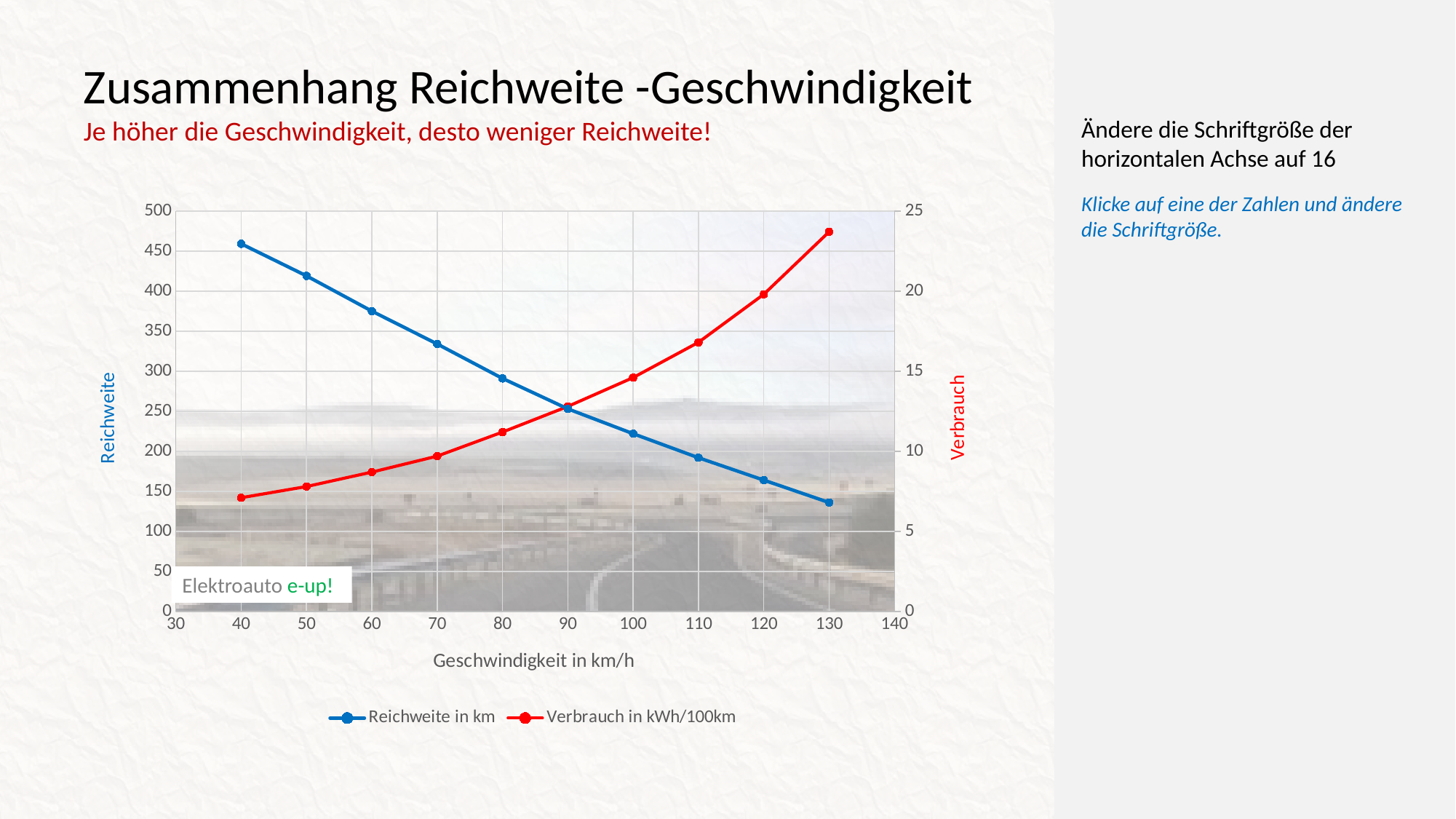
Is the Reichweite in km value at 60 km/h greater or less than 350? greater At which speed (Geschwindigkeit) is Reichweite in km highest? 40 What kind of chart is shown on the slide? line chart Is the Reichweite in km value at 130 km/h greater or less than 150? less Is the Verbrauch in kWh/100km value at 130 km/h greater or less than 20? greater How many series does the chart legend list? 2 At which speed (Geschwindigkeit) is Verbrauch in kWh/100km highest? 130 At which speed (Geschwindigkeit) is Verbrauch in kWh/100km lowest? 40 How many data points does the Reichweite in km series have? 10 What is the title of the horizontal axis of the chart? Geschwindigkeit in km/h Does Reichweite in km rise or fall as Geschwindigkeit increases? fall Does Verbrauch in kWh/100km rise or fall as Geschwindigkeit increases? rise